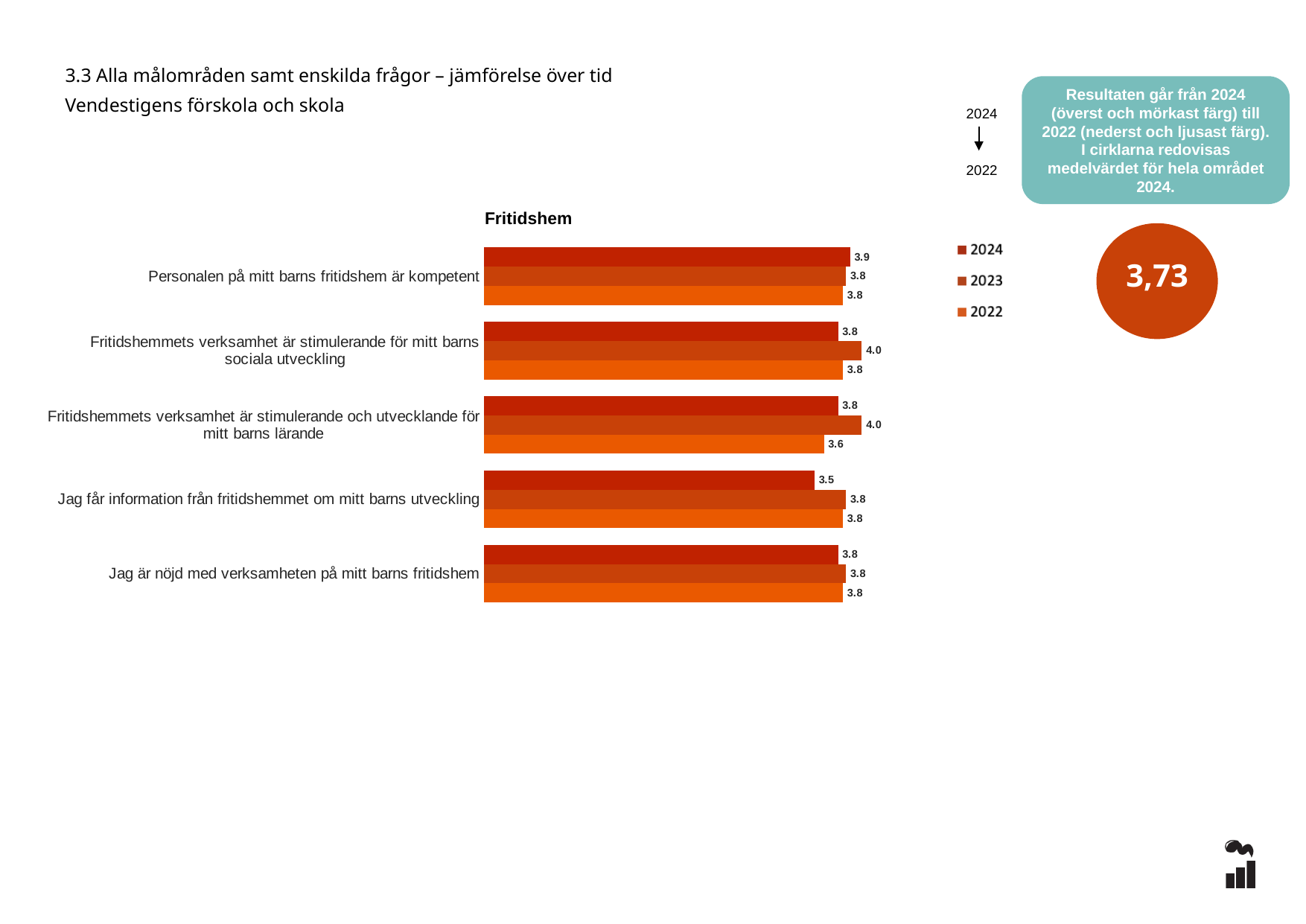
How many categories (questions) are shown in the chart? 5 What is the 2024 value for "Personalen på mitt barns fritidshem är kompetent"? 3.9 Which category has the lowest 2024 value? Jag får information från fritidshemmet om mitt barns utveckling What mean value for the whole area in 2024 is shown in the circle? 3,73 What is the difference between the 2023 and 2024 values for "Jag får information från fritidshemmet om mitt barns utveckling"? 0.3 Which category has the highest 2024 value? Personalen på mitt barns fritidshem är kompetent How many series does the legend list? 3 What is the 2024 value for "Jag får information från fritidshemmet om mitt barns utveckling"? 3.5 What is the 2023 value for "Fritidshemmets verksamhet är stimulerande för mitt barns sociala utveckling"? 4.0 What kind of chart is shown on the slide? Bar chart What is the 2022 value for "Fritidshemmets verksamhet är stimulerande och utvecklande för mitt barns lärande"? 3.6 For "Fritidshemmets verksamhet är stimulerande och utvecklande för mitt barns lärande", which year has the larger value, 2023 or 2022? 2023